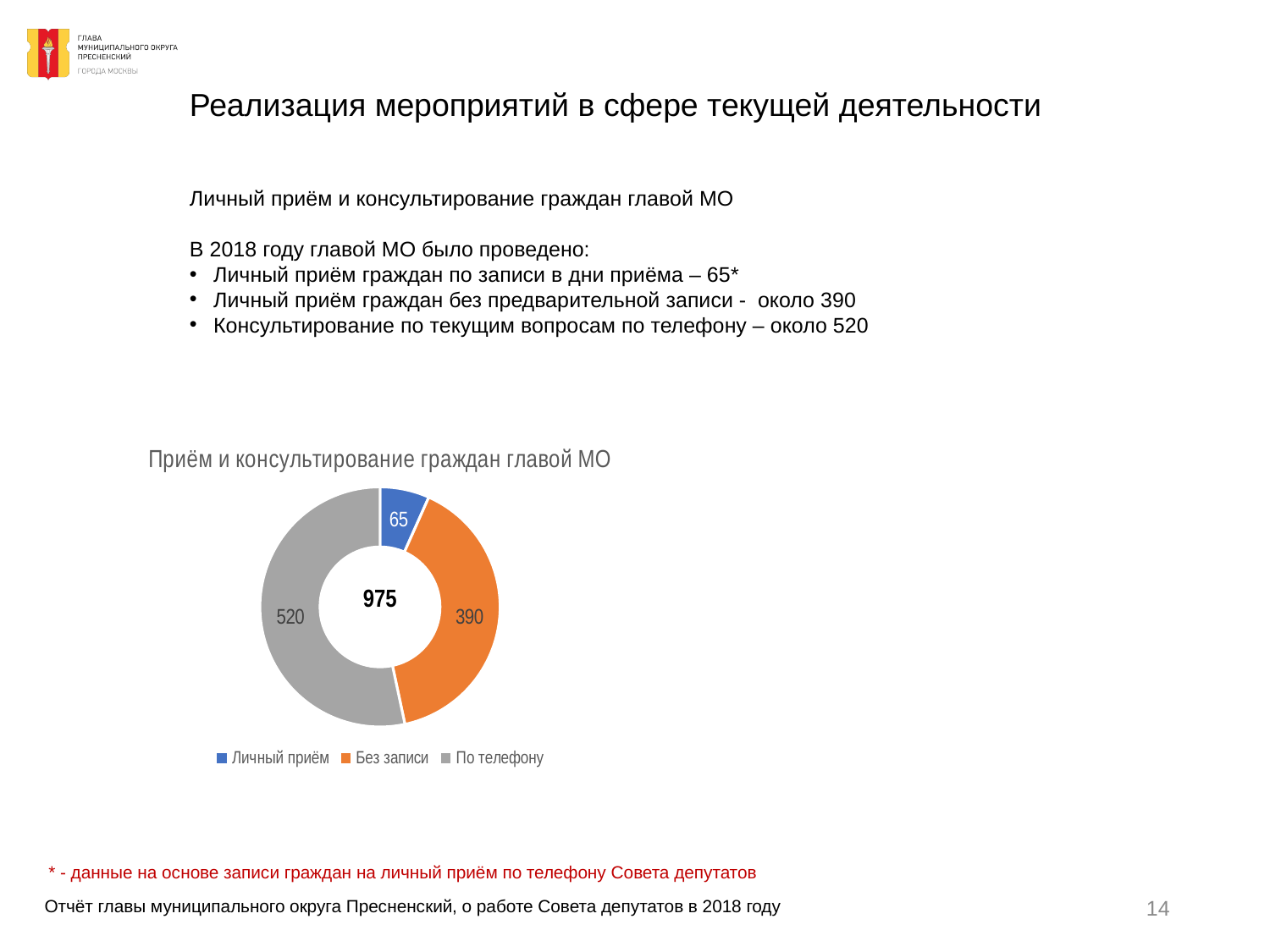
Which category has the smallest value in the chart? Личный приём What is the value for «По телефону» in the chart? 520 Which is larger: the value for «Без записи» or the value for «Личный приём»? Без записи What is the value for «Личный приём» in the chart? 65 What is the value for «Без записи» in the chart? 390 What is the total of all values shown in the chart? 975 How many categories does the chart show? 3 What is the difference between the values for «По телефону» and «Без записи»? 130 Which colour represents «По телефону» in the chart? Grey What type of chart is shown on the slide? Doughnut chart Which category has the largest value in the chart? По телефону What is the title of the chart? Приём и консультирование граждан главой МО